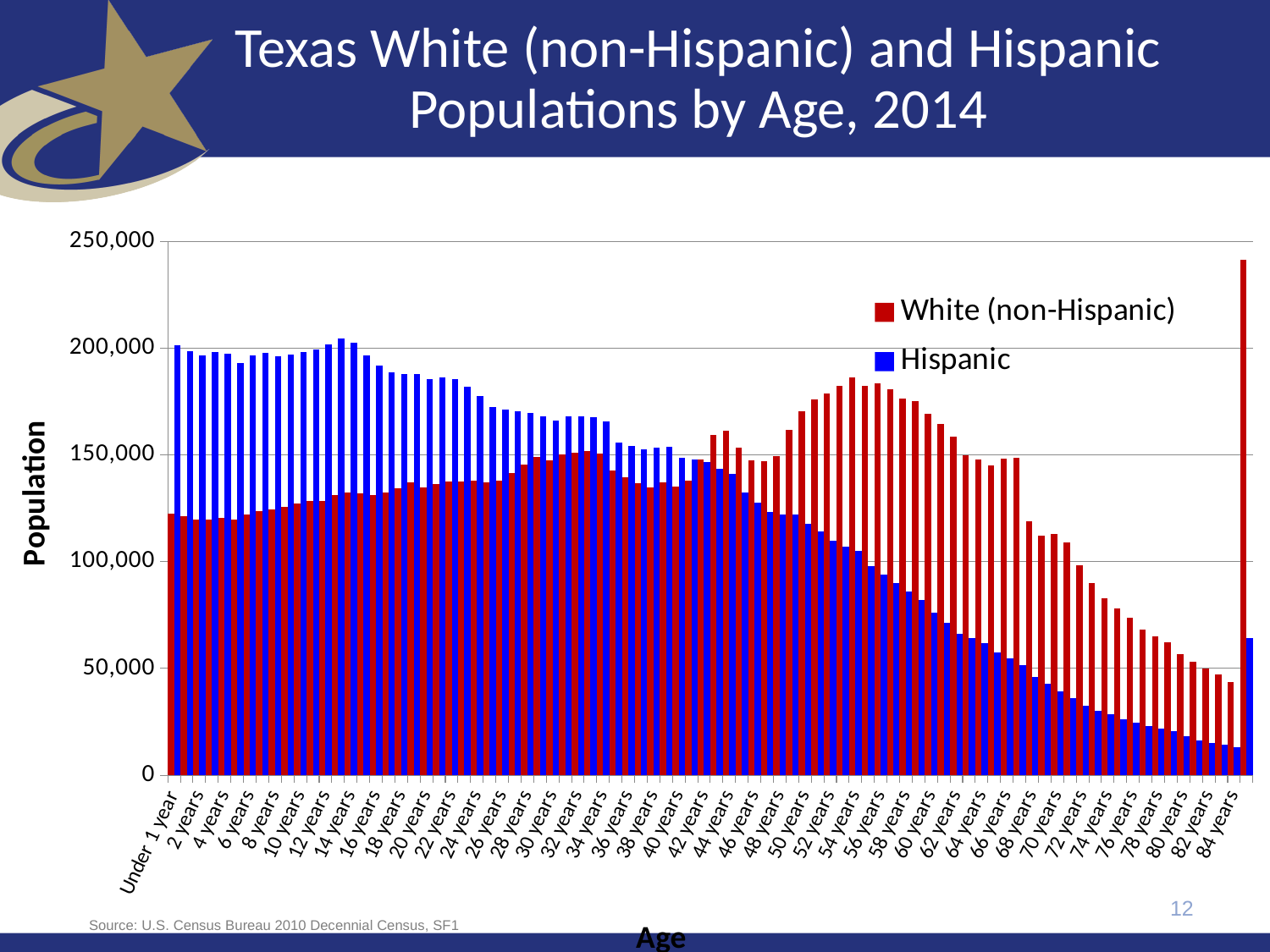
At 54 years, which series has the larger value, White (non-Hispanic) or Hispanic? White (non-Hispanic) At 2 years, which series has the larger value, White (non-Hispanic) or Hispanic? Hispanic Is the White (non-Hispanic) value for 54 years greater or less than 150,000? greater Is the Hispanic value for 60 years greater or less than 100,000? less Is the White (non-Hispanic) value for Under 1 year greater or less than 100,000? greater What is the title of the vertical axis? Population At 40 years, which series has the larger value, White (non-Hispanic) or Hispanic? Hispanic What kind of chart is shown on the slide? bar chart Which colour represents the Hispanic series? blue Do the Hispanic values rise or fall from 50 years to 84 years? fall How many series does the legend list? 2